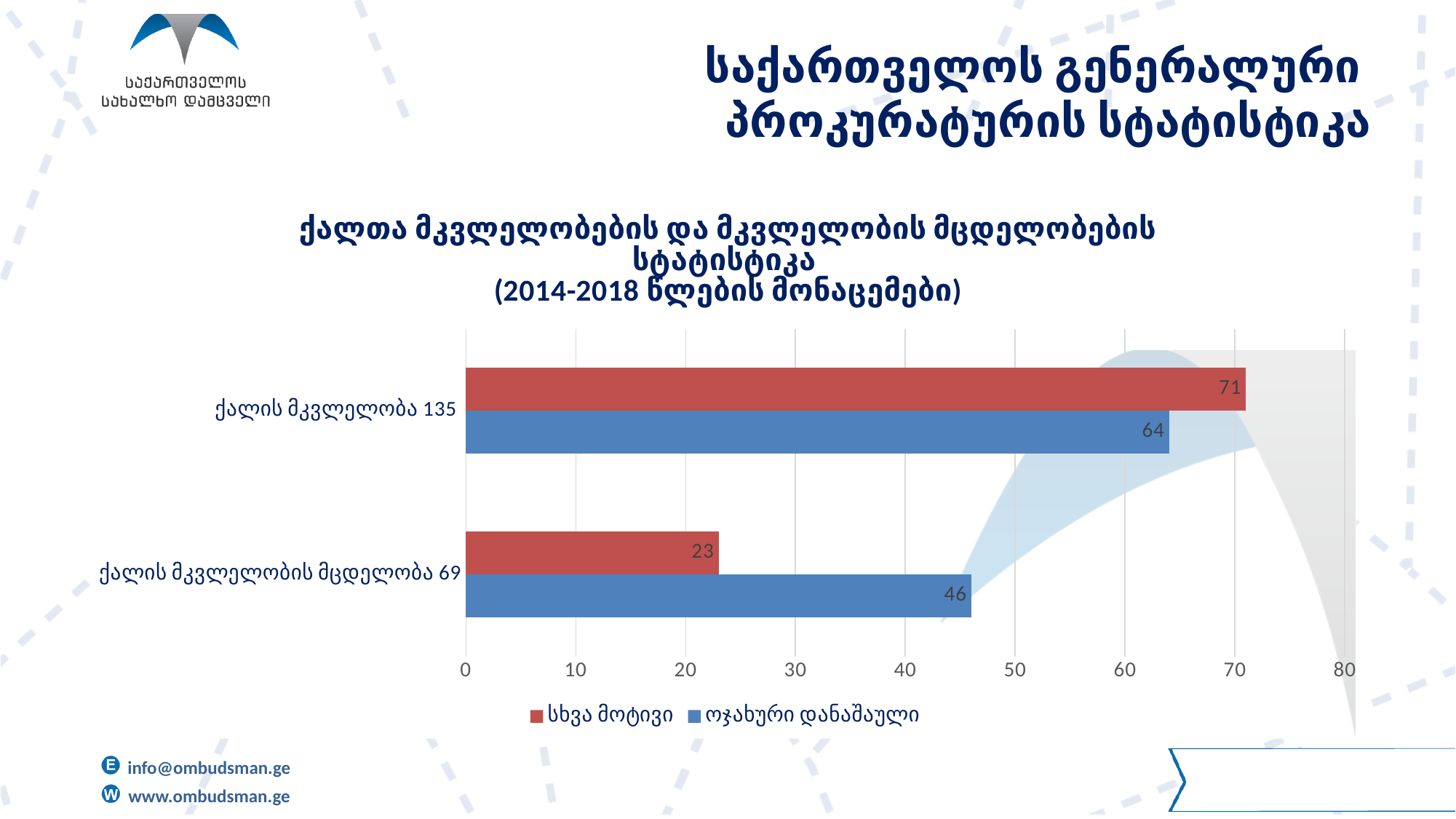
What is the value of the "ოჯახური დანაშაული" series for "ქალის მკვლელობა 135"? 64 What is the difference between the "ოჯახური დანაშაული" and "სხვა მოტივი" values for "ქალის მკვლელობის მცდელობა 69"? 23 How many series does the legend list? 2 What is the value of the "სხვა მოტივი" series for "ქალის მკვლელობის მცდელობა 69"? 23 Which bar has the lowest value on the chart? სხვა მოტივი for ქალის მკვლელობის მცდელობა 69 What is the value of the "სხვა მოტივი" series for "ქალის მკვლელობა 135"? 71 Which bar has the highest value on the chart? სხვა მოტივი for ქალის მკვლელობა 135 Which colour represents the "ოჯახური დანაშაული" series in the legend? blue For "ქალის მკვლელობა 135", which series has the larger value, "სხვა მოტივი" or "ოჯახური დანაშაული"? სხვა მოტივი What is the value of the "ოჯახური დანაშაული" series for "ქალის მკვლელობის მცდელობა 69"? 46 How many categories are shown on the chart? 2 What type of chart is shown on the slide? bar chart